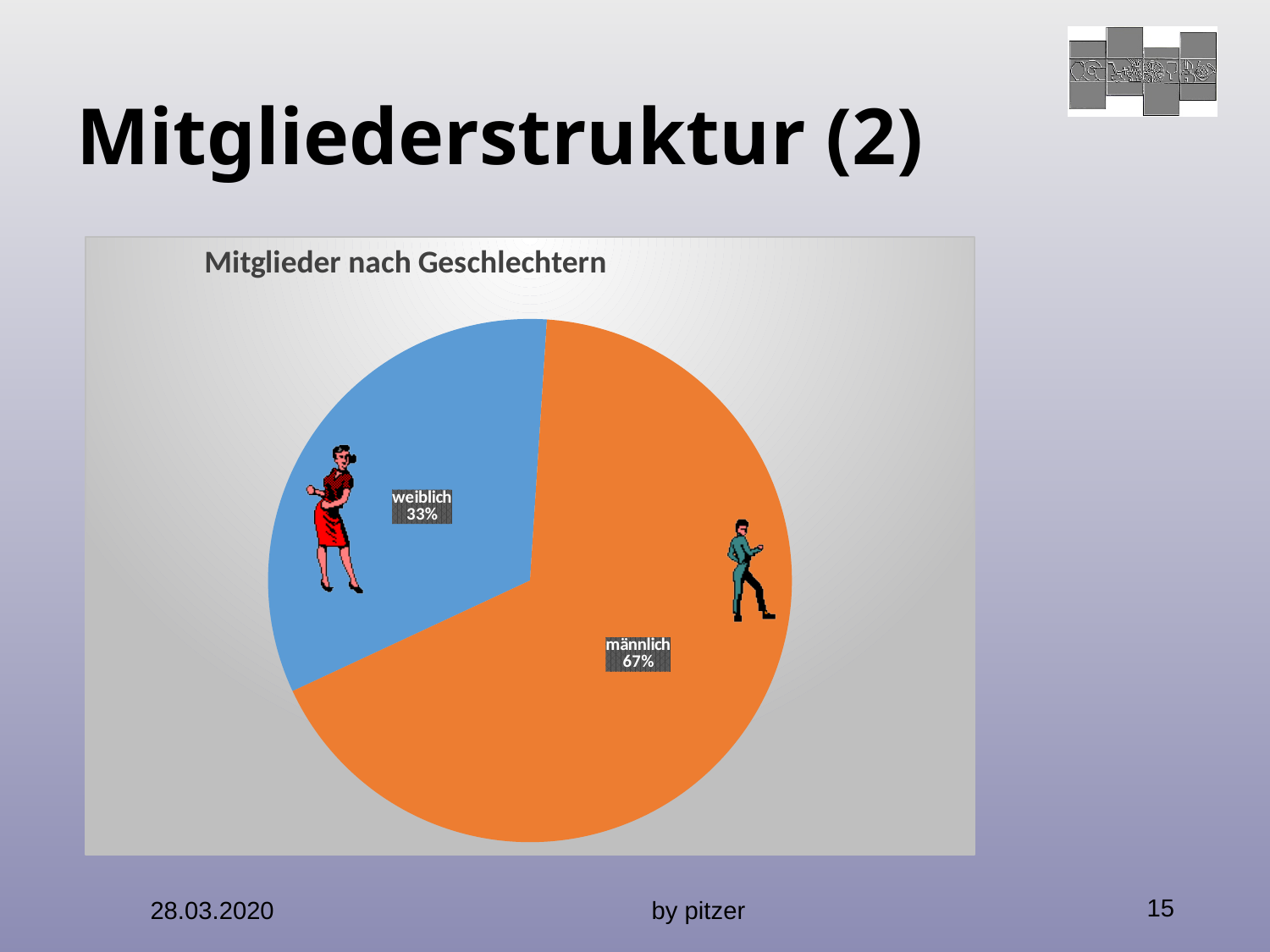
What colour is the weiblich slice? blue Which slice of the pie is the smallest? weiblich Which slice of the pie is the largest? männlich What share of the pie is labelled männlich? 67% What share of the pie is labelled weiblich? 33% Which is larger, the share for männlich or the share for weiblich? männlich How many slices does the pie chart have? 2 What kind of chart is shown on the slide? pie chart What is the title of the chart? Mitglieder nach Geschlechtern What is the difference in percentage points between the männlich and weiblich shares? 34